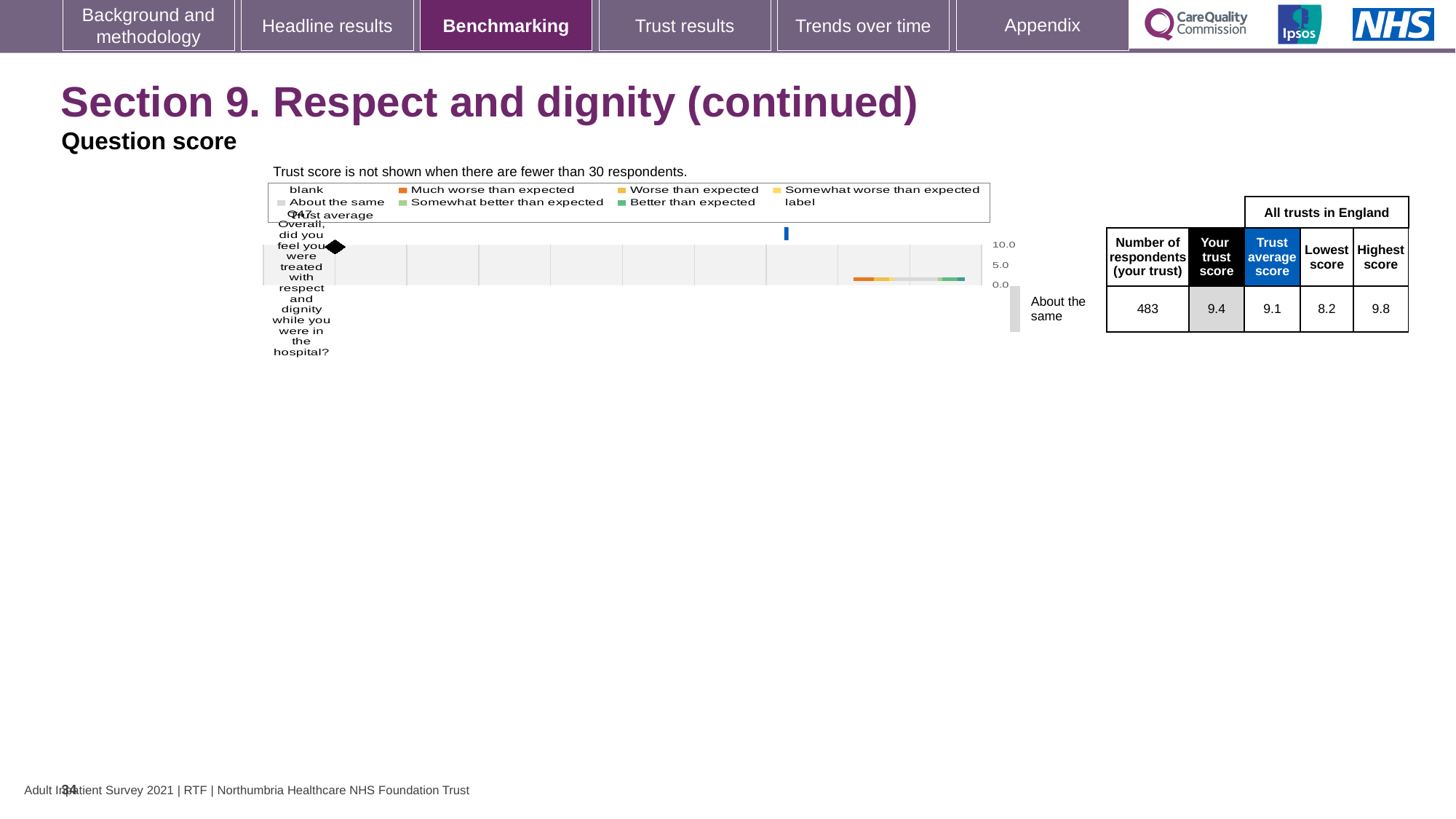
According to the table, what is the number of respondents for your trust? 483 How is your trust's result categorised relative to expectations on this chart? About the same What is the difference between your trust score and the trust average score? 0.3 What is the difference between the highest score and the lowest score in the table? 1.6 According to the table, what is the lowest score among all trusts in England? 8.2 Which is larger, your trust score or the trust average score? Your trust score According to the table, what is the trust average score for all trusts in England? 9.1 According to the table, what is the highest score among all trusts in England? 9.8 What colour does the legend use for 'Much worse than expected'? orange What kind of chart is shown on the slide? bar chart What is the highest value shown on the chart's numeric axis? 10.0 According to the table, what is your trust score? 9.4